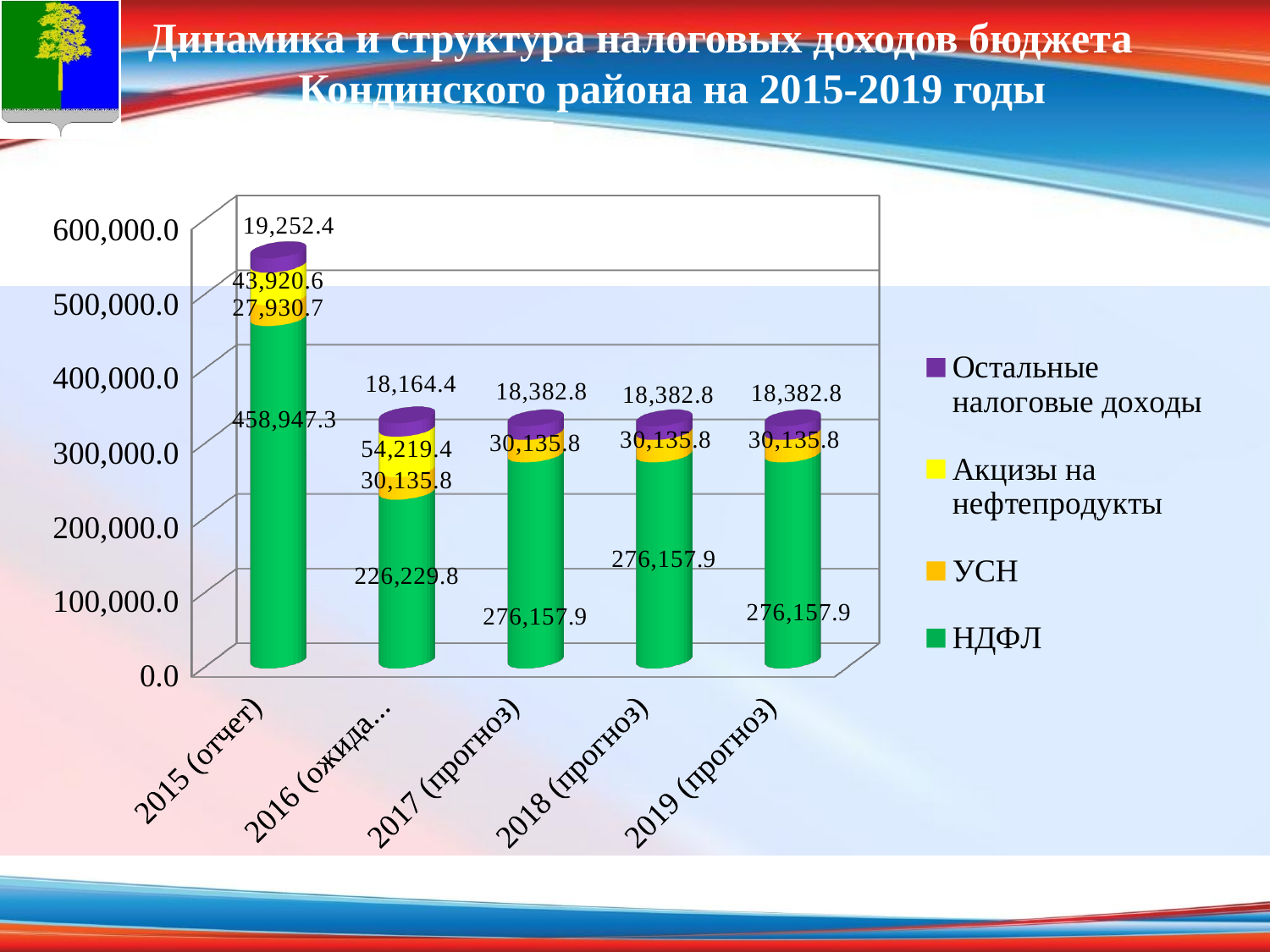
How many series does the legend list? 4 In which year is НДФЛ the highest? 2015 (отчет) What is the total of the stacked bar for 2015 (отчет)? 550,051.0 In which year is НДФЛ the lowest? 2016 How many years (categories) are shown on the x axis? 5 What is the value of Остальные налоговые доходы for 2018 (прогноз)? 18,382.8 What is the difference between НДФЛ in 2015 and НДФЛ in 2016? 232,717.5 What is the value of Остальные налоговые доходы for 2015 (отчет)? 19,252.4 What is the value of Акцизы на нефтепродукты for 2016? 54,219.4 What is the value of НДФЛ for 2016? 226,229.8 What is the value of НДФЛ for 2015 (отчет)? 458,947.3 Which is larger: Акцизы на нефтепродукты in 2015 or in 2016? 2016